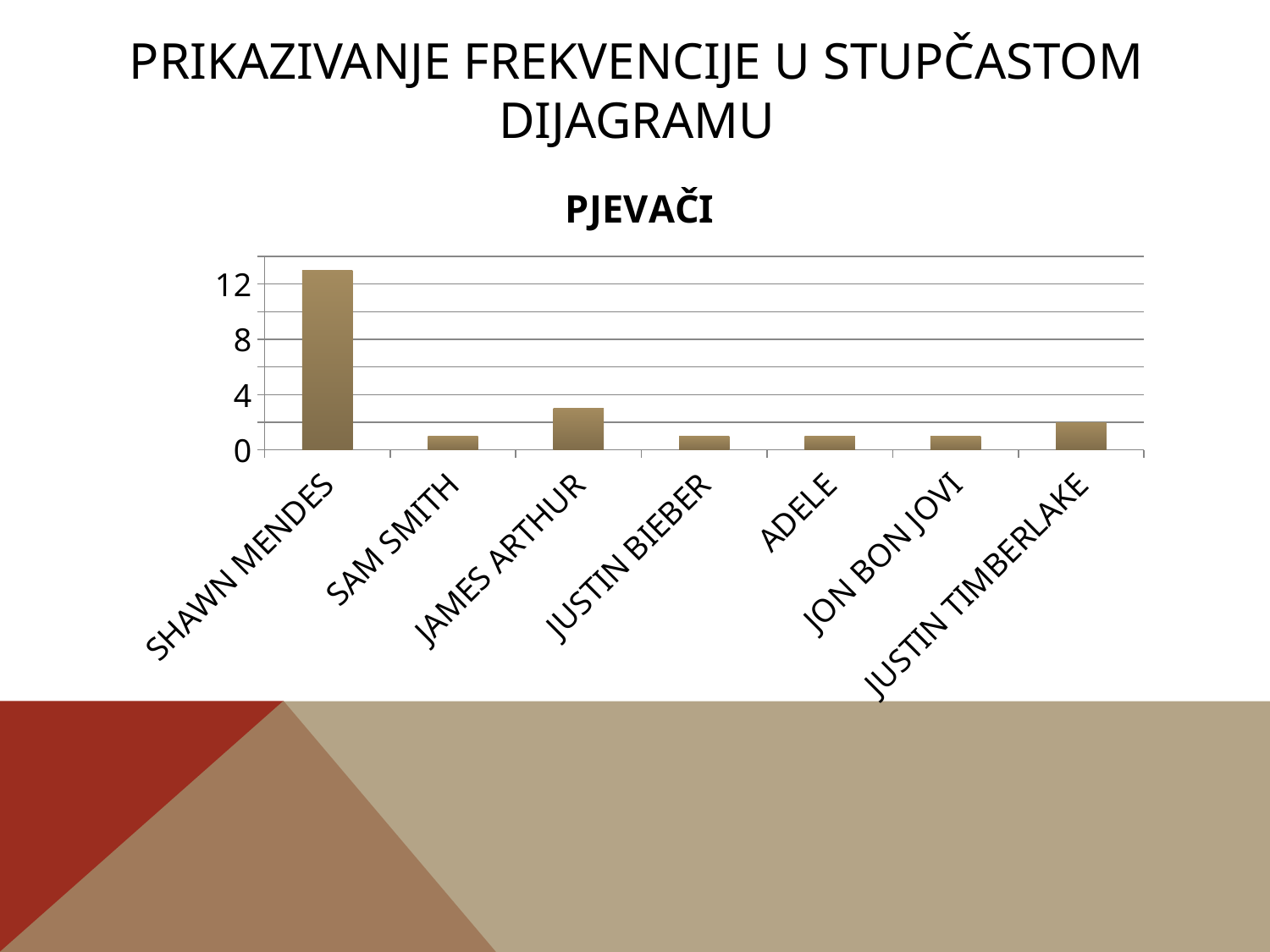
Is the value for SHAWN MENDES greater or less than 12? greater Which is larger, the value for JUSTIN TIMBERLAKE or the value for ADELE? JUSTIN TIMBERLAKE Which is larger, the value for JAMES ARTHUR or the value for JUSTIN TIMBERLAKE? JAMES ARTHUR How many singers (categories) are shown on the x axis of the chart? 7 Is the value for JUSTIN TIMBERLAKE greater or less than 4? less What kind of chart is shown on the slide? bar chart Which singer has the highest bar in the chart? SHAWN MENDES Is the value for JAMES ARTHUR greater or less than 4? less Which is larger, the value for SHAWN MENDES or the value for JAMES ARTHUR? SHAWN MENDES What is the title of the chart? PJEVAČI